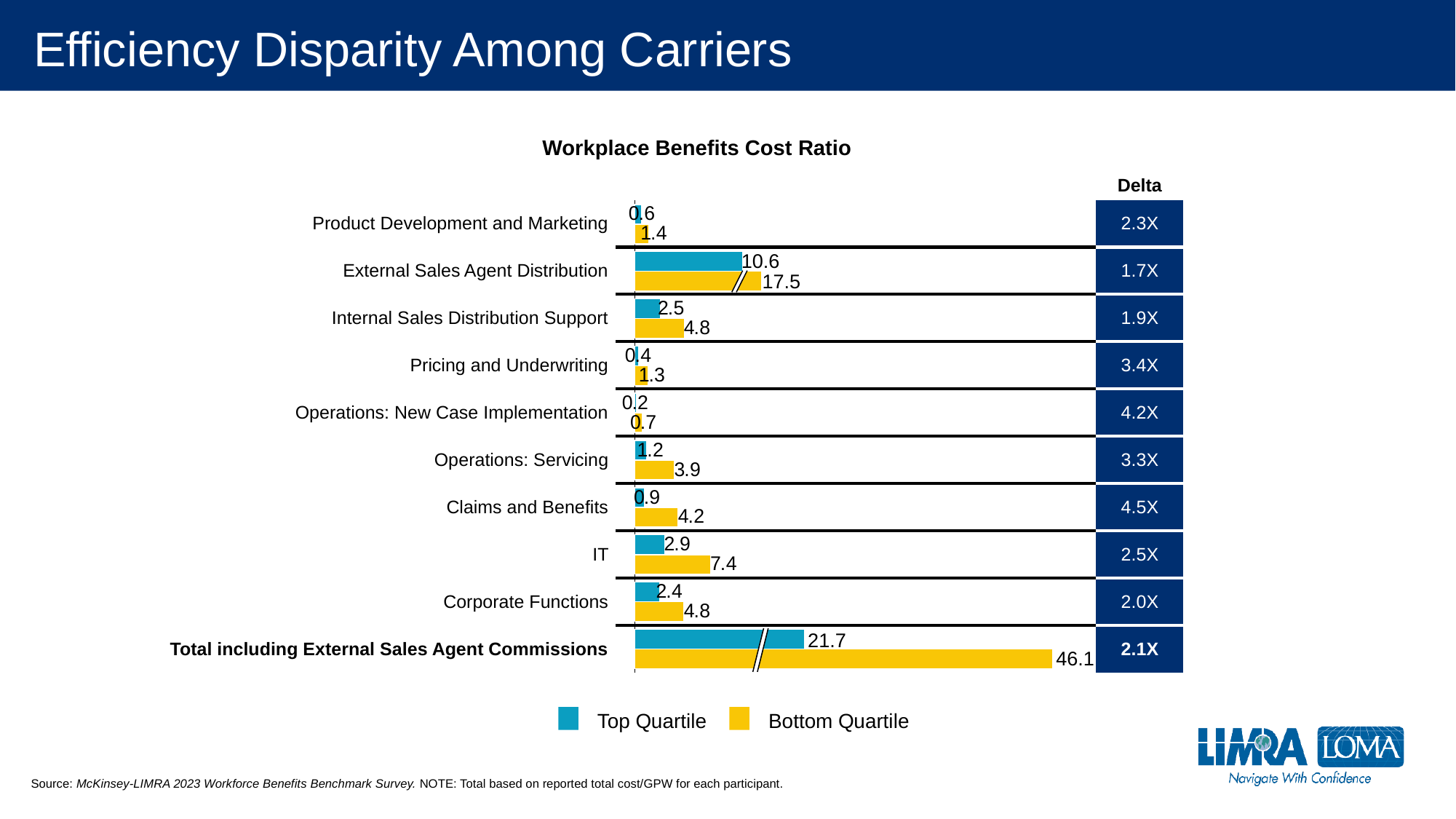
What is the Bottom Quartile value for IT? 7.4 Excluding the Total row, which category has the highest Bottom Quartile value? External Sales Agent Distribution What is the Top Quartile value for External Sales Agent Distribution? 10.6 What is the Delta shown for Claims and Benefits? 4.5X Which category has the lowest Top Quartile value? Operations: New Case Implementation Which is larger, the Top Quartile value for IT or the Top Quartile value for Corporate Functions? IT How many categories are shown on the chart? 10 What is the Bottom Quartile value for Total including External Sales Agent Commissions? 46.1 What kind of chart is shown on the slide? Bar chart What is the difference between the Bottom Quartile and Top Quartile values for Internal Sales Distribution Support? 2.3 How many series does the legend list? 2 What is the title of the chart? Workplace Benefits Cost Ratio